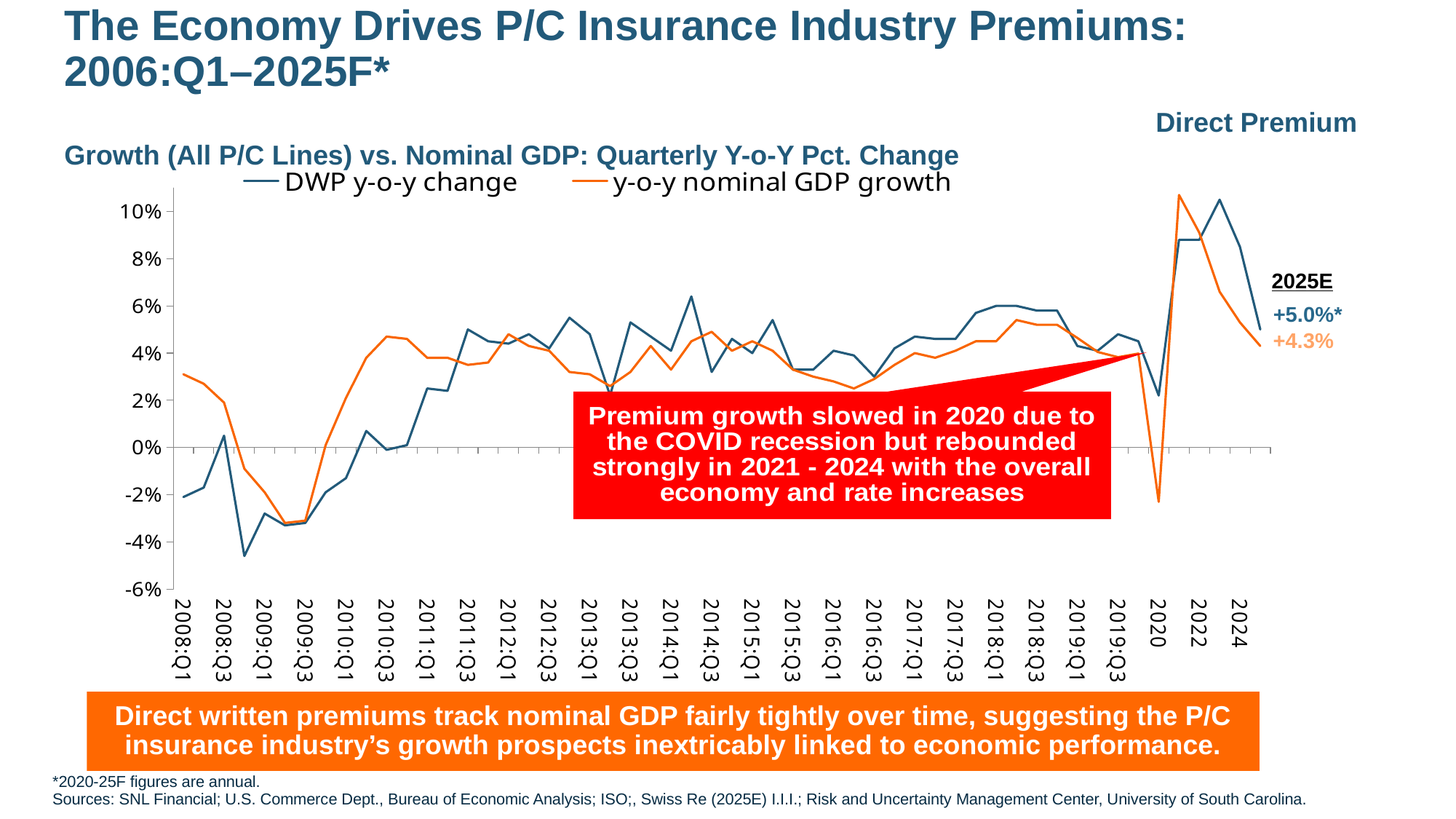
How many series does the chart legend list? 2 What type of chart is shown on the slide? Line chart Is the DWP y-o-y change value for 2008:Q1 greater or less than 0%? less What is the highest value shown on the chart's y-axis? 10% What is the 2025E value for y-o-y nominal GDP growth? +4.3% Is the y-o-y nominal GDP growth value for 2020 greater or less than 0%? less For 2025E, which is larger: DWP y-o-y change or y-o-y nominal GDP growth? DWP y-o-y change Is the y-o-y nominal GDP growth value for 2008:Q1 greater or less than 2%? greater What colour is the line for y-o-y nominal GDP growth? Orange What is the difference between the 2025E DWP y-o-y change and the 2025E y-o-y nominal GDP growth? 0.7 percentage points From 2008:Q3 to 2009:Q1, does the y-o-y nominal GDP growth line rise or fall? fall What is the 2025E value for DWP y-o-y change? +5.0%